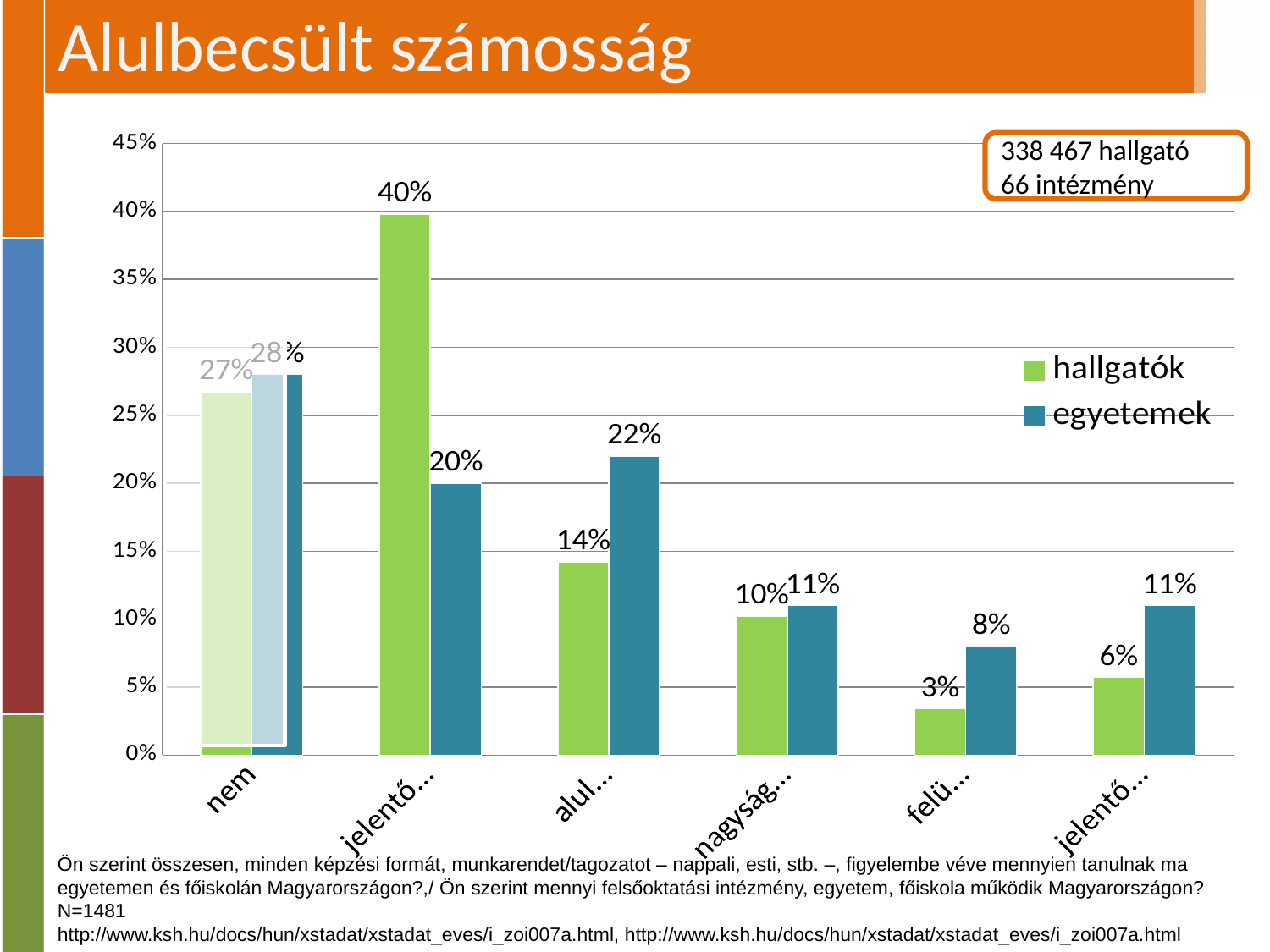
What is the difference between the egyetemek and hallgatók values for the category labelled "alul…"? 8 percentage points What is the highest value shown for the hallgatók series? 40% How many categories are shown on the x axis? 6 What is the egyetemek value for the category labelled "felü…"? 8% What are the two series named in the legend? hallgatók and egyetemek For the category labelled "nagyság…", which series has the larger value, hallgatók or egyetemek? egyetemek What kind of chart is shown on the slide? bar chart Is the egyetemek value for the category labelled "alul…" greater or less than 20%? greater For the second category from the left ("jelentő…"), how much larger is the hallgatók value than the egyetemek value? 20 percentage points What is the hallgatók value for the category labelled "alul…"? 14% What is the egyetemek value for the rightmost category ("jelentő…")? 11% How many series does the legend list? 2